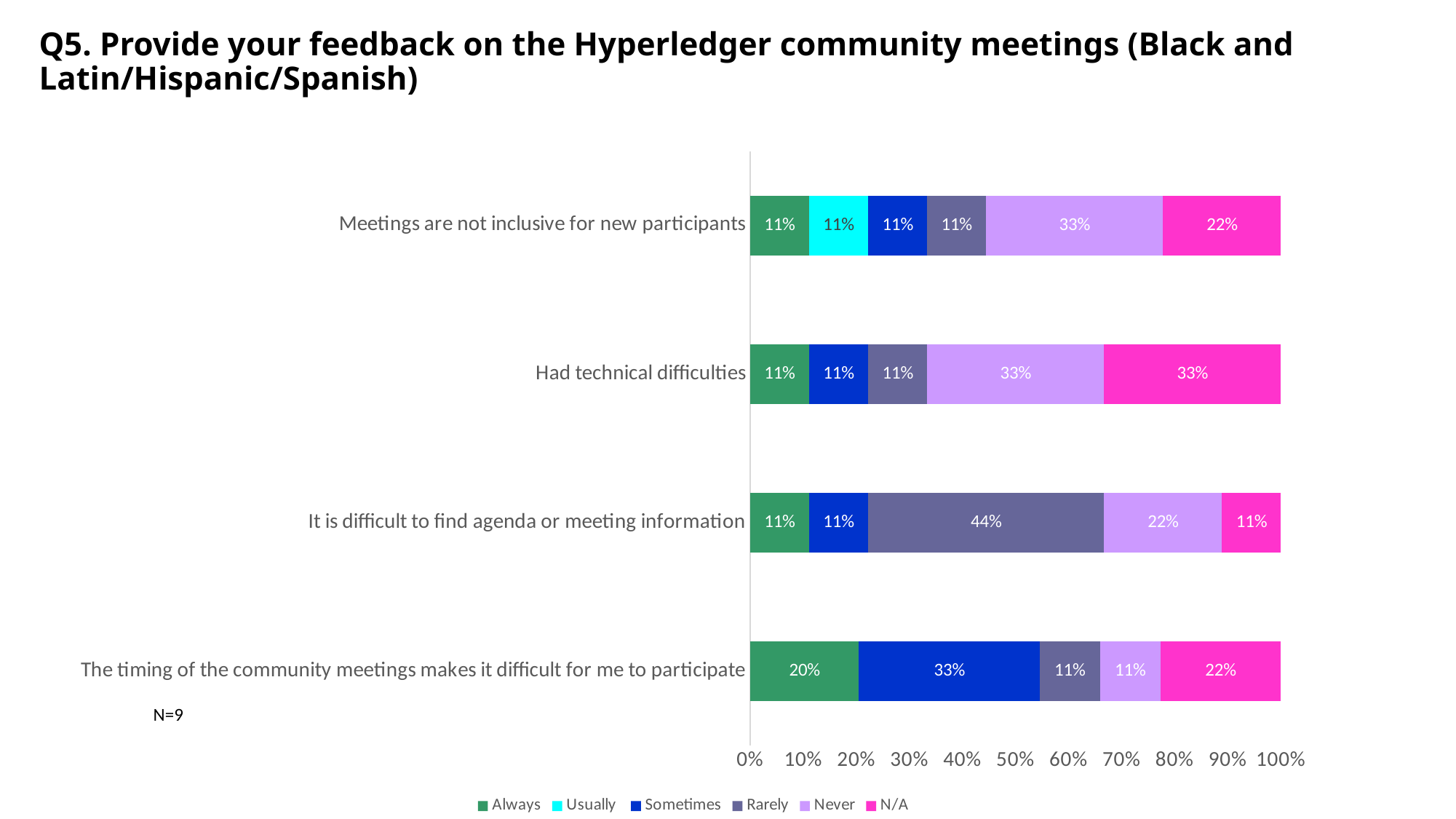
How many series does the legend list? 6 What kind of chart is shown on the slide? Stacked bar chart What is the 'N/A' value for 'Had technical difficulties'? 33% What sample size (N) is shown on the slide? N=9 Which is larger: the 'N/A' value for 'Had technical difficulties' or the 'N/A' value for 'It is difficult to find agenda or meeting information'? Had technical difficulties What is the 'Rarely' value for 'It is difficult to find agenda or meeting information'? 44% Which statement has the highest 'Sometimes' value? The timing of the community meetings makes it difficult for me to participate Which statement has the highest 'Rarely' value? It is difficult to find agenda or meeting information What is the 'Never' value for 'Meetings are not inclusive for new participants'? 33% What is the difference between the 'Sometimes' value for 'The timing of the community meetings makes it difficult for me to participate' and the 'Sometimes' value for 'Had technical difficulties'? 22% How many categories (statements) are plotted in the chart? 4 What is the 'Always' value for 'The timing of the community meetings makes it difficult for me to participate'? 20%